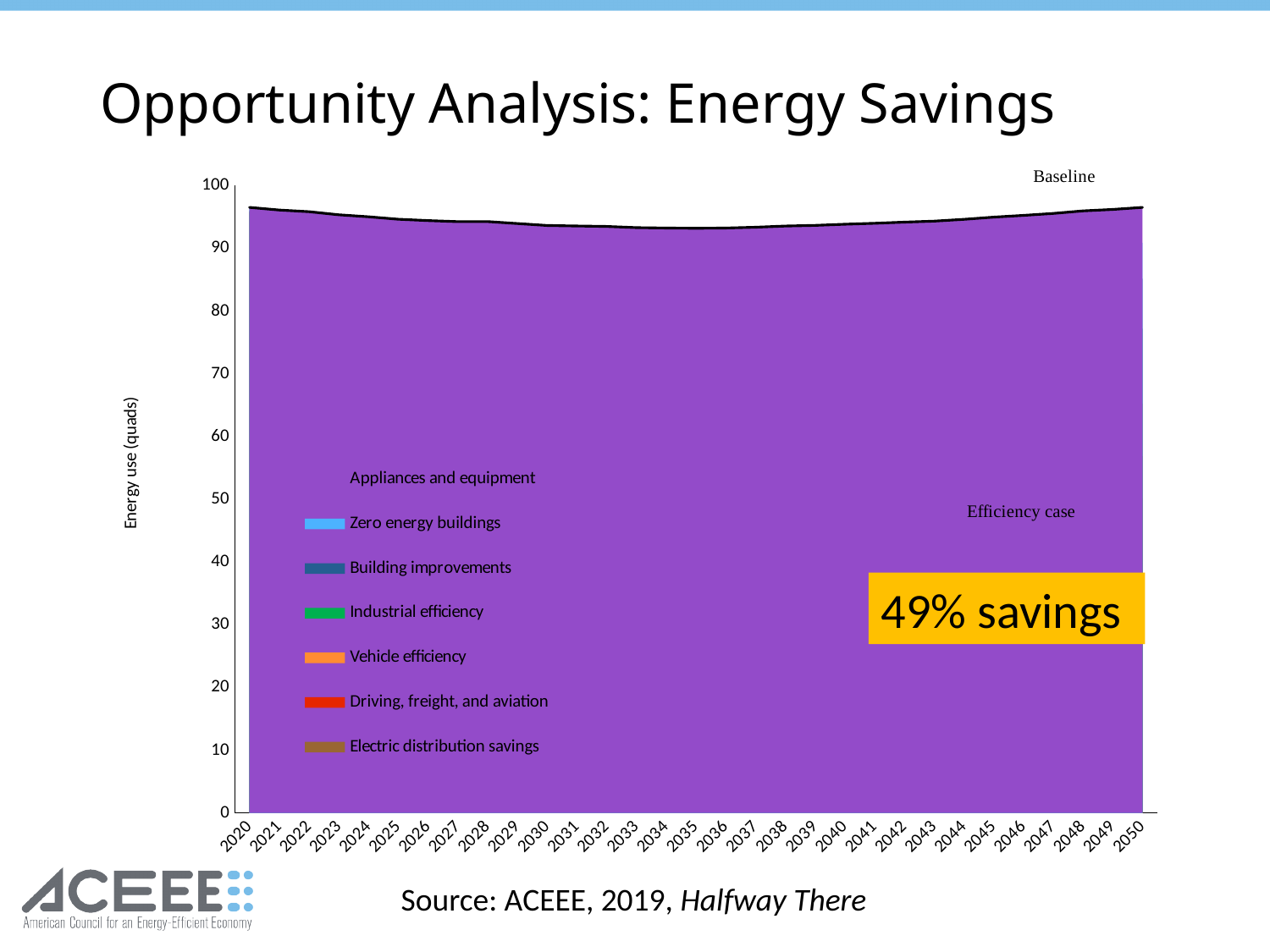
What is the first year shown on the x axis of the chart? 2020 How many years are labelled along the x axis of the chart? 31 Is the Baseline value in 2035 greater or less than 100? less How many entries does the legend of the chart list? 7 What is the last year shown on the x axis of the chart? 2050 What is the label on the y axis of the chart? Energy use (quads) What kind of chart is shown on the slide? Area chart What percentage of savings is highlighted in the yellow box on the chart? 49% savings Does the Baseline line fall or rise between 2020 and 2035? Fall Is the Baseline value in 2020 greater or less than 90? greater Is the Baseline value in 2050 greater or less than 80? greater What is the highest value shown on the y axis of the chart? 100